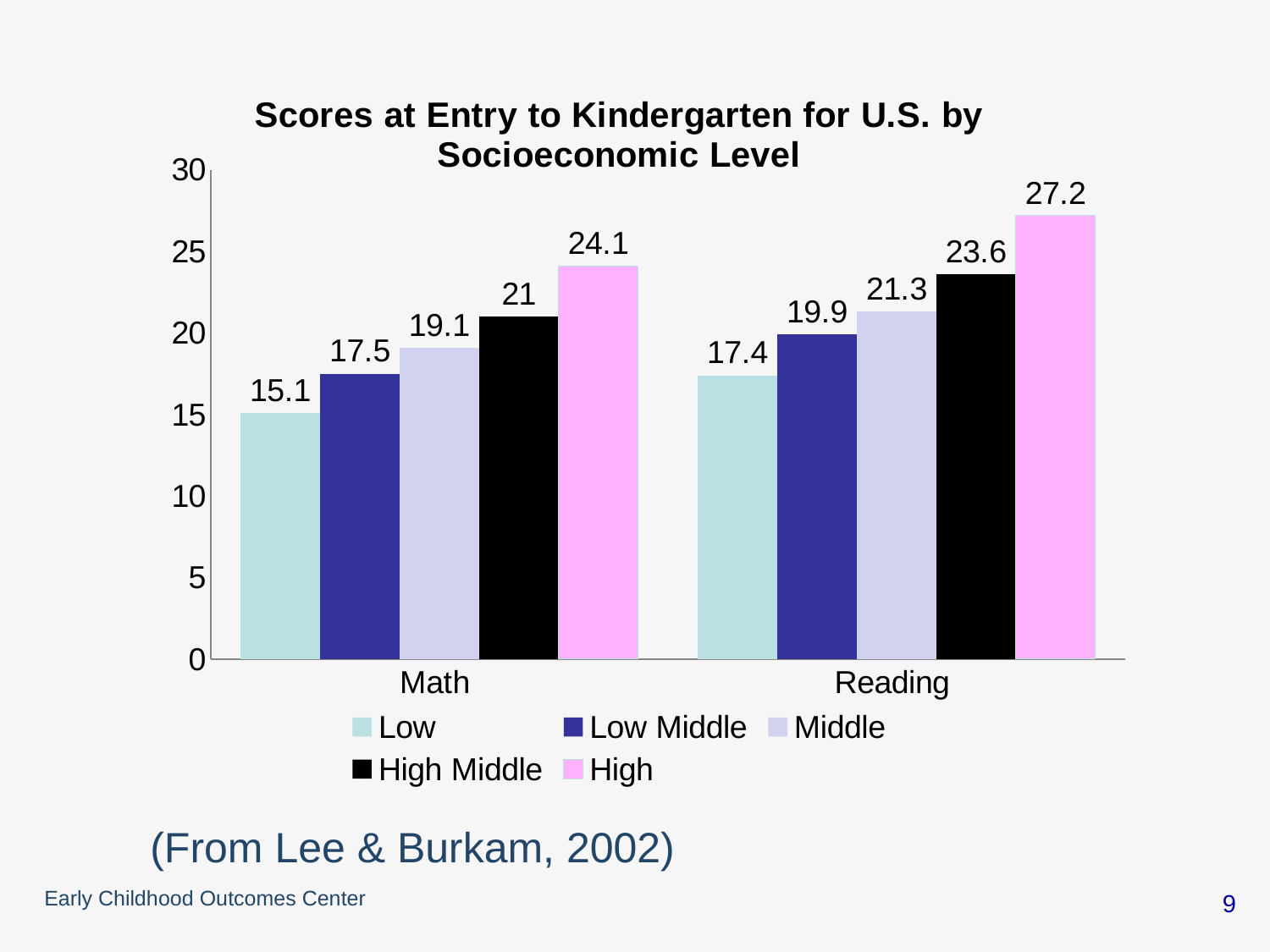
Which socioeconomic group has the lowest Reading score? Low What is the Reading score for the High socioeconomic group? 27.2 Which socioeconomic group has the highest Math score? High What is the Reading score for the Middle socioeconomic group? 21.3 Is the High Math score greater or less than 25? less What kind of chart is shown on the slide? Bar chart What is the difference between the High Middle Reading score and the High Middle Math score? 2.6 What is the title of the chart? Scores at Entry to Kindergarten for U.S. by Socioeconomic Level What is the Math score for the Low socioeconomic group? 15.1 What is the difference between the High and Low Reading scores? 9.8 How many series does the legend list? 5 Which is larger, the Low Middle Math score or the Low Middle Reading score? Low Middle Reading score